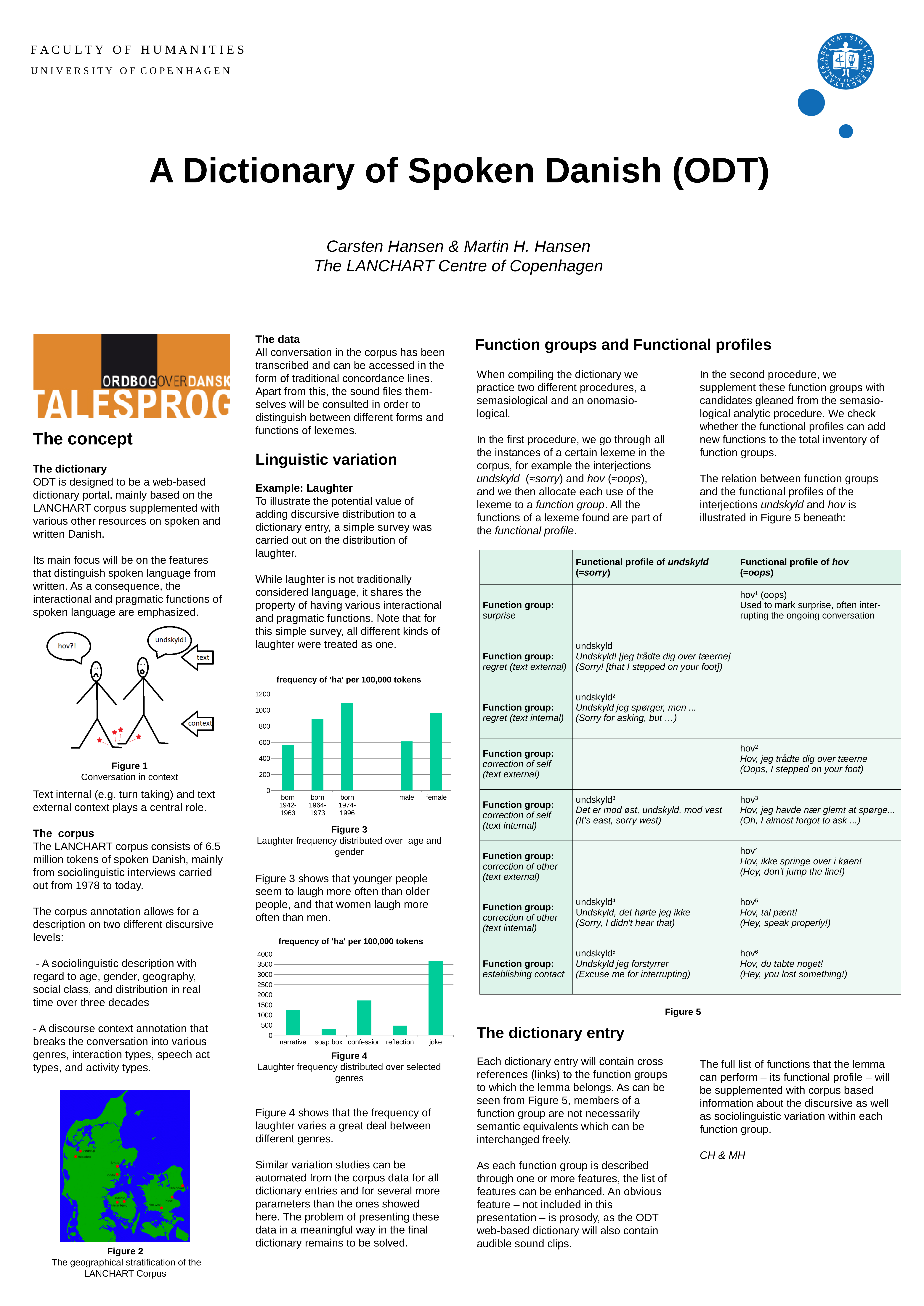
In Figure 3, which category has the highest frequency of 'ha' per 100,000 tokens? born 1974-1996 In Figure 4, is the value for joke greater or less than 3500? greater In Figure 3, is the value for born 1974-1996 greater or less than 1000? greater In Figure 4, which is larger, the value for narrative or the value for confession? confession In Figure 3, which category has the lowest frequency of 'ha' per 100,000 tokens? born 1942-1963 In Figure 3, how many bars are plotted? 5 In Figure 3, what kind of chart is used? bar chart In Figure 4, which genre has the highest frequency of 'ha' per 100,000 tokens? joke In Figure 3, do the values rise or fall across the three birth-year groups from born 1942-1963 to born 1974-1996? rise What is the title of the chart in Figure 4? frequency of 'ha' per 100,000 tokens In Figure 4, which genre has the lowest frequency of 'ha' per 100,000 tokens? soap box In Figure 3, which is larger, the value for male or the value for female? female